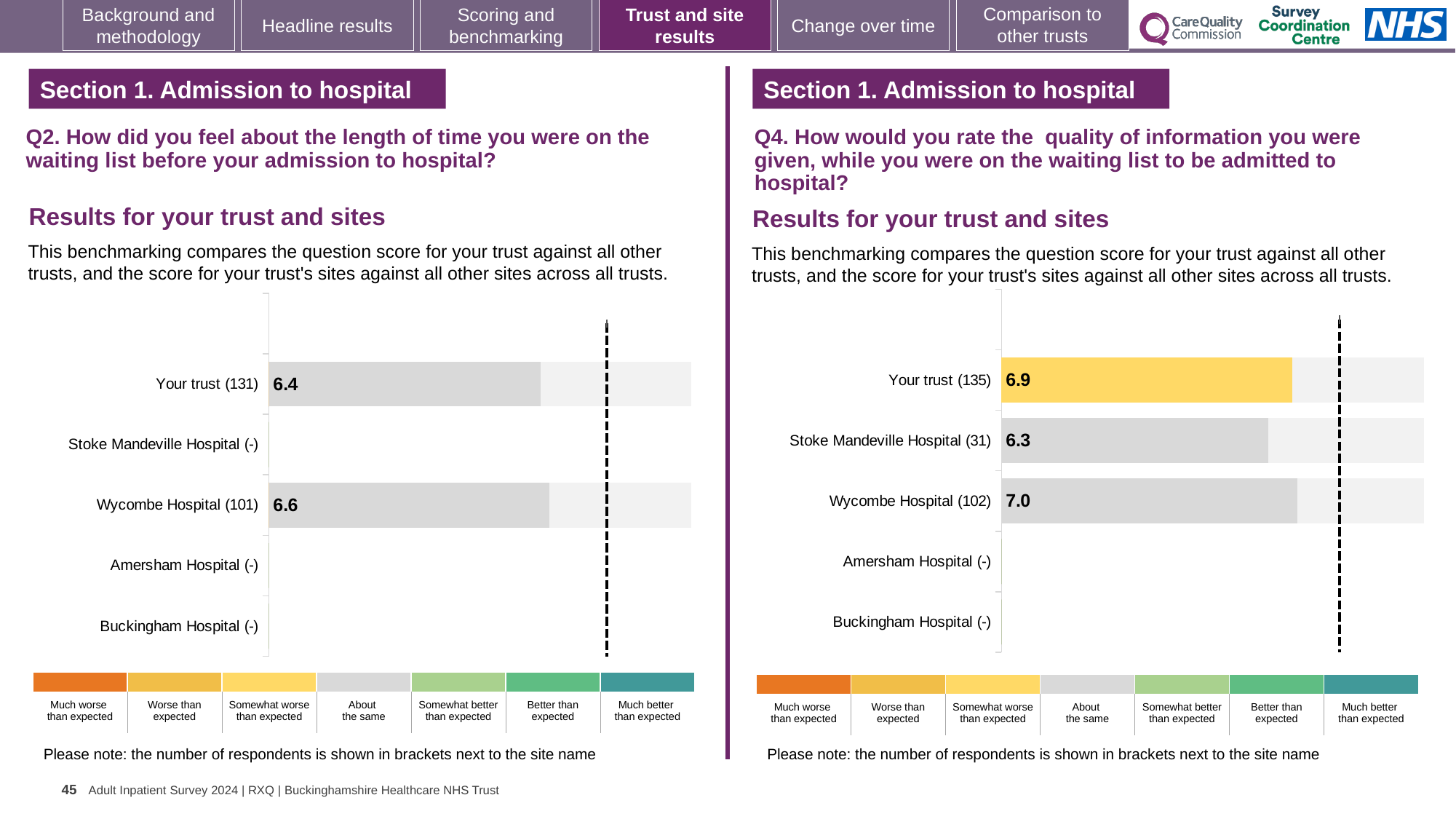
On the Q4 chart (right), what is the score for Your trust (135)? 6.9 On the Q4 chart (right), which site or trust has the lowest plotted score? Stoke Mandeville Hospital (31) On the Q4 chart (right), what is the difference between the scores for Wycombe Hospital (102) and Stoke Mandeville Hospital (31)? 0.7 On the Q4 chart (right), what is the score for Stoke Mandeville Hospital (31)? 6.3 On the Q2 chart (left), what is the difference between the scores for Wycombe Hospital (101) and Your trust (131)? 0.2 On the Q2 chart (left), what is the score for Wycombe Hospital (101)? 6.6 On the Q2 chart (left), which has the larger score, Your trust (131) or Wycombe Hospital (101)? Wycombe Hospital (101) On the Q2 chart (left), what is the score for Your trust (131)? 6.4 What kind of chart is used on the Q4 chart (right)? Bar chart How many categories (trust and sites) are listed on the Q2 chart (left)? 5 On the Q4 chart (right), which site or trust has the highest score? Wycombe Hospital (102) On the Q4 chart (right), what is the score for Wycombe Hospital (102)? 7.0